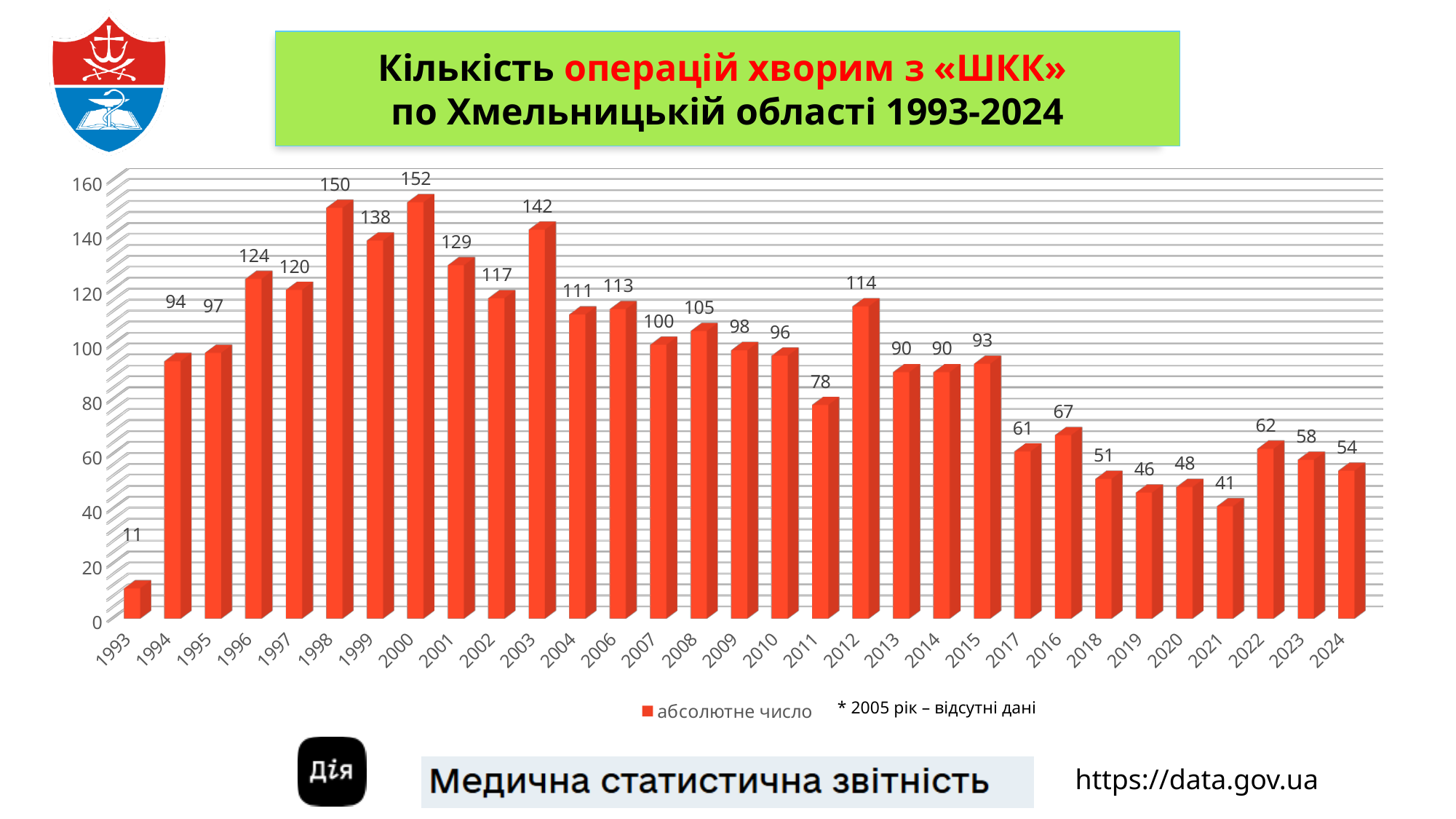
Which is larger, the value for 2016 or the value for 2017? 2016 Which year has the highest value? 2000 What is the value for 2000? 152 What is the difference between the values for 1998 and 2021? 109 What kind of chart is shown? bar chart What is the value for 2024? 54 What is the legend entry for the series? абсолютне число Is the value for 2003 greater or less than 140? greater Which year has the lowest value? 1993 What is the value for 2012? 114 How many years are shown on the x axis? 31 How many series does the legend list? 1